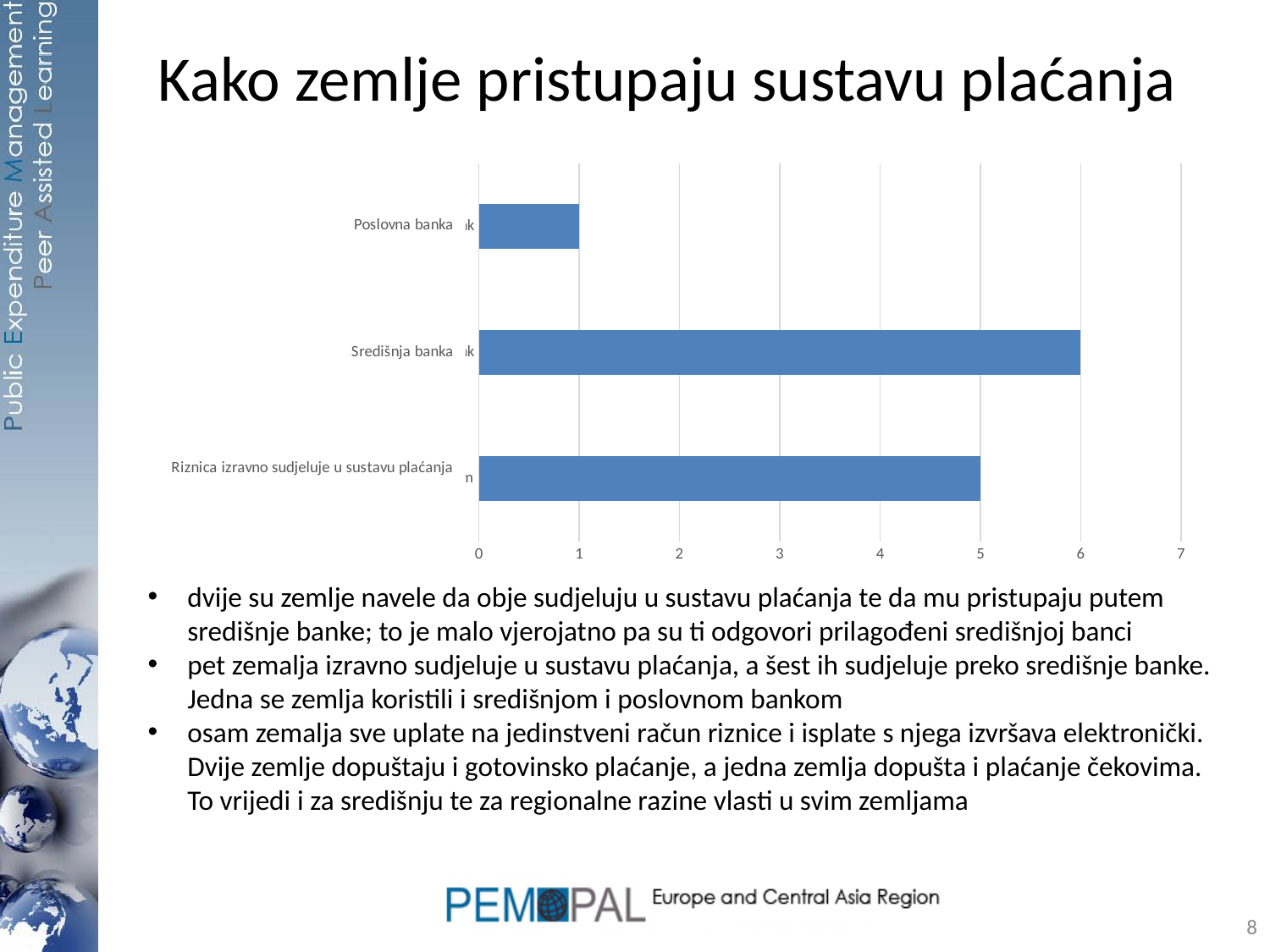
What is the value for Poslovna banka? 1 What is the maximum value shown on the horizontal axis? 7 What is the value for Riznica izravno sudjeluje u sustavu plaćanja? 5 What kind of chart is shown on the slide? bar chart Which category has the lowest value? Poslovna banka What is the value for Središnja banka? 6 Which category has the highest value? Središnja banka What is the difference between the values for Središnja banka and Riznica izravno sudjeluje u sustavu plaćanja? 1 What is the difference between the values for Središnja banka and Poslovna banka? 5 Which is larger, the value for Riznica izravno sudjeluje u sustavu plaćanja or the value for Poslovna banka? Riznica izravno sudjeluje u sustavu plaćanja Is the value for Središnja banka greater or less than 4? greater How many categories does the chart show? 3